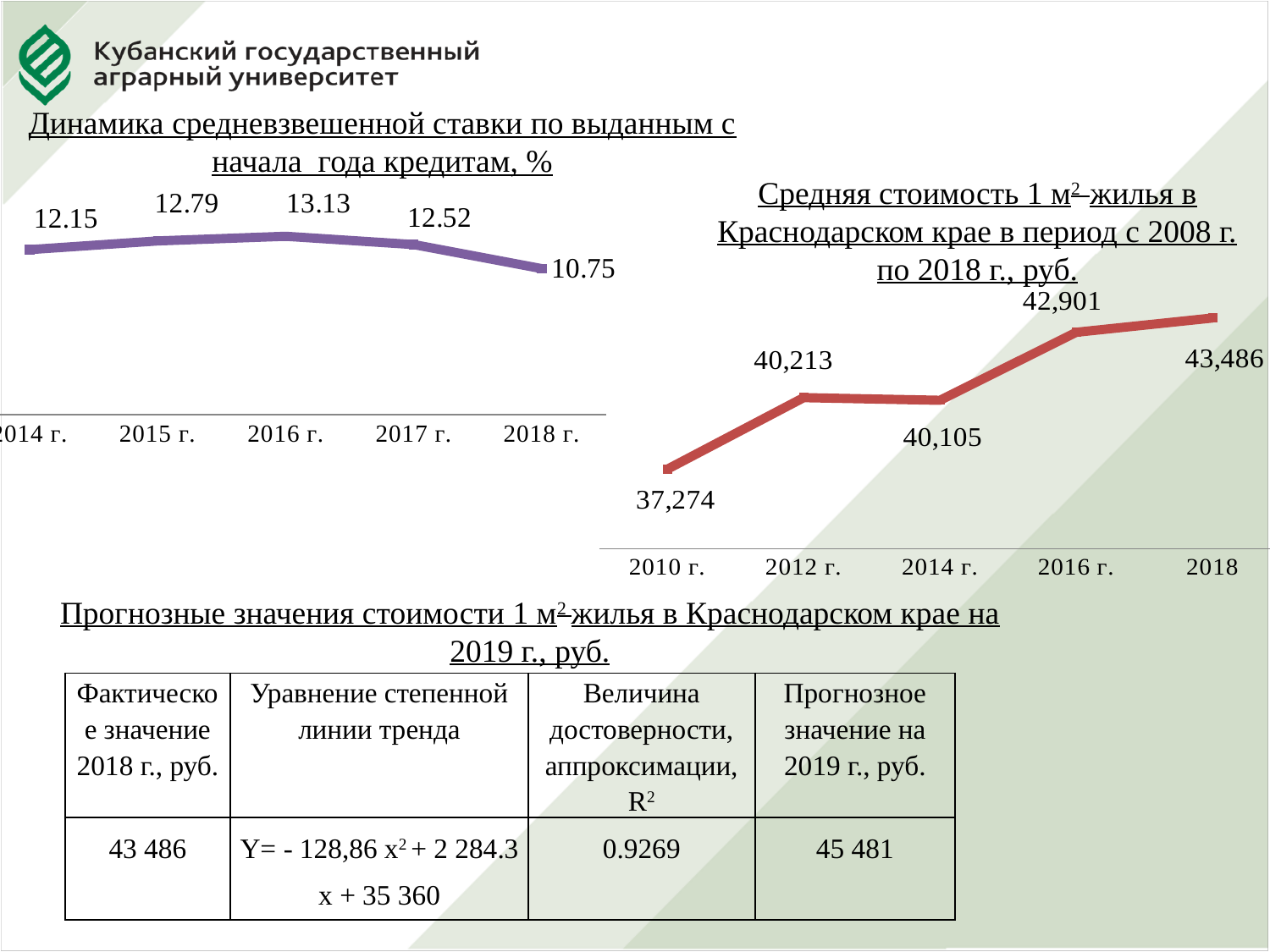
In the left chart (weighted average rate on loans), which year has the highest value? 2016 г. In the left chart (weighted average rate on loans), which year has the lowest value? 2018 г. In the right chart (average cost of 1 m² of housing), what is the value for 2016 г.? 42,901 What type of chart is the right chart (average cost of 1 m² of housing)? Line chart In the left chart (weighted average rate on loans), how many years are plotted? 5 In the left chart (weighted average rate on loans), what is the value for 2016 г.? 13.13 In the left chart (weighted average rate on loans), what is the value for 2018 г.? 10.75 In the right chart (average cost of 1 m² of housing), what is the difference between the 2018 and 2010 г. values? 6,212 In the right chart (average cost of 1 m² of housing), what is the value for 2010 г.? 37,274 In the right chart (average cost of 1 m² of housing), which is larger, the value for 2012 г. or 2014 г.? 2012 г. In the left chart (weighted average rate on loans), what is the difference between the 2016 г. and 2018 г. values? 2.38 In the right chart (average cost of 1 m² of housing), which year has the highest value? 2018